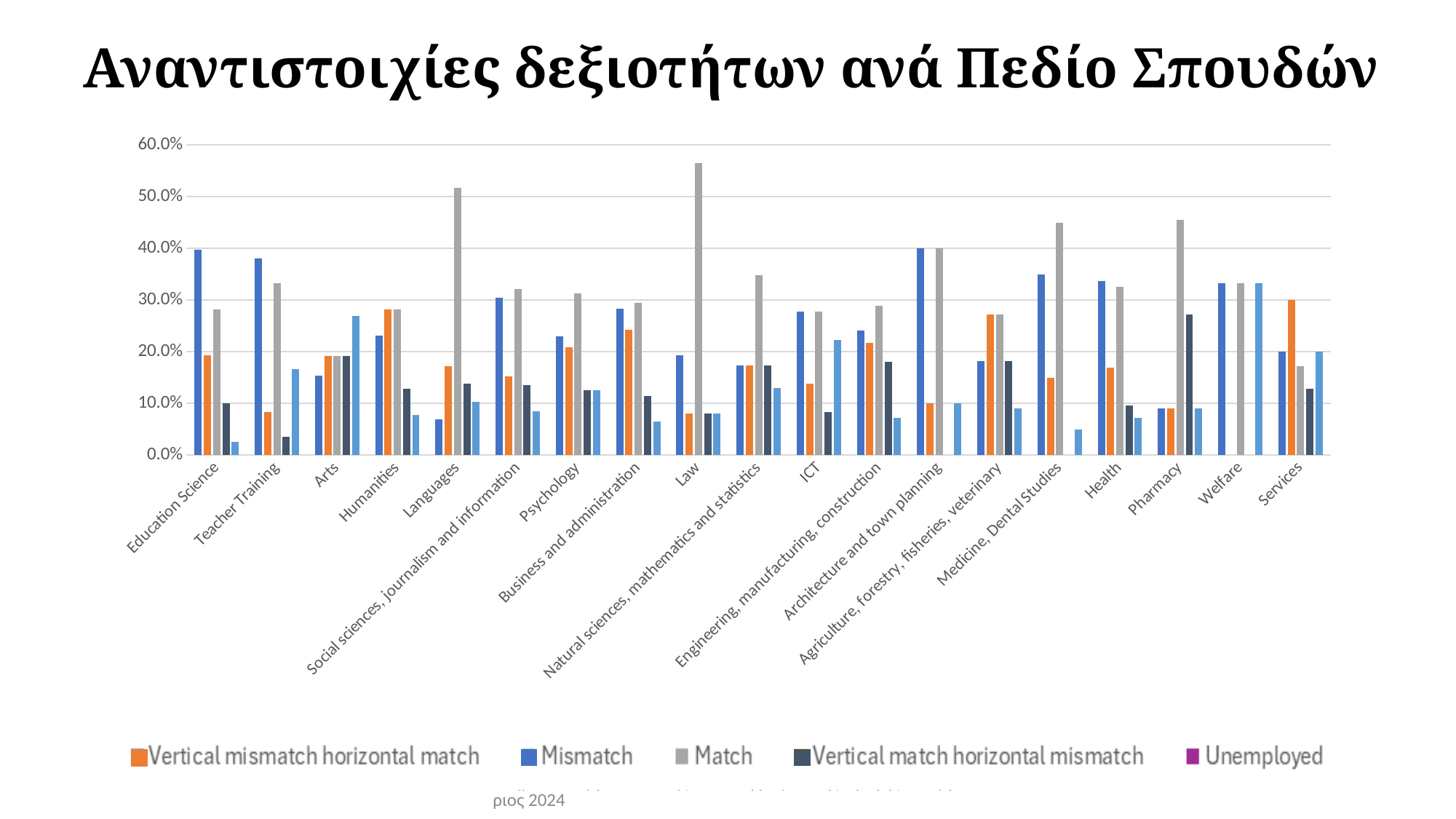
How many series does the legend list? 5 Is the Match value for Medicine, Dental Studies greater or less than 40.0%? greater How many fields of study are shown on the x axis? 19 Is the Match value for Law greater or less than 50.0%? greater Which field of study has the highest value for the Match series? Law Is the Vertical match horizontal mismatch value for Pharmacy greater or less than 20.0%? greater What is the title of the chart? Αναντιστοιχίες δεξιοτήτων ανά Πεδίο Σπουδών What kind of chart is shown on the slide? Bar chart For Law, which is larger: the Match value or the Mismatch value? Match